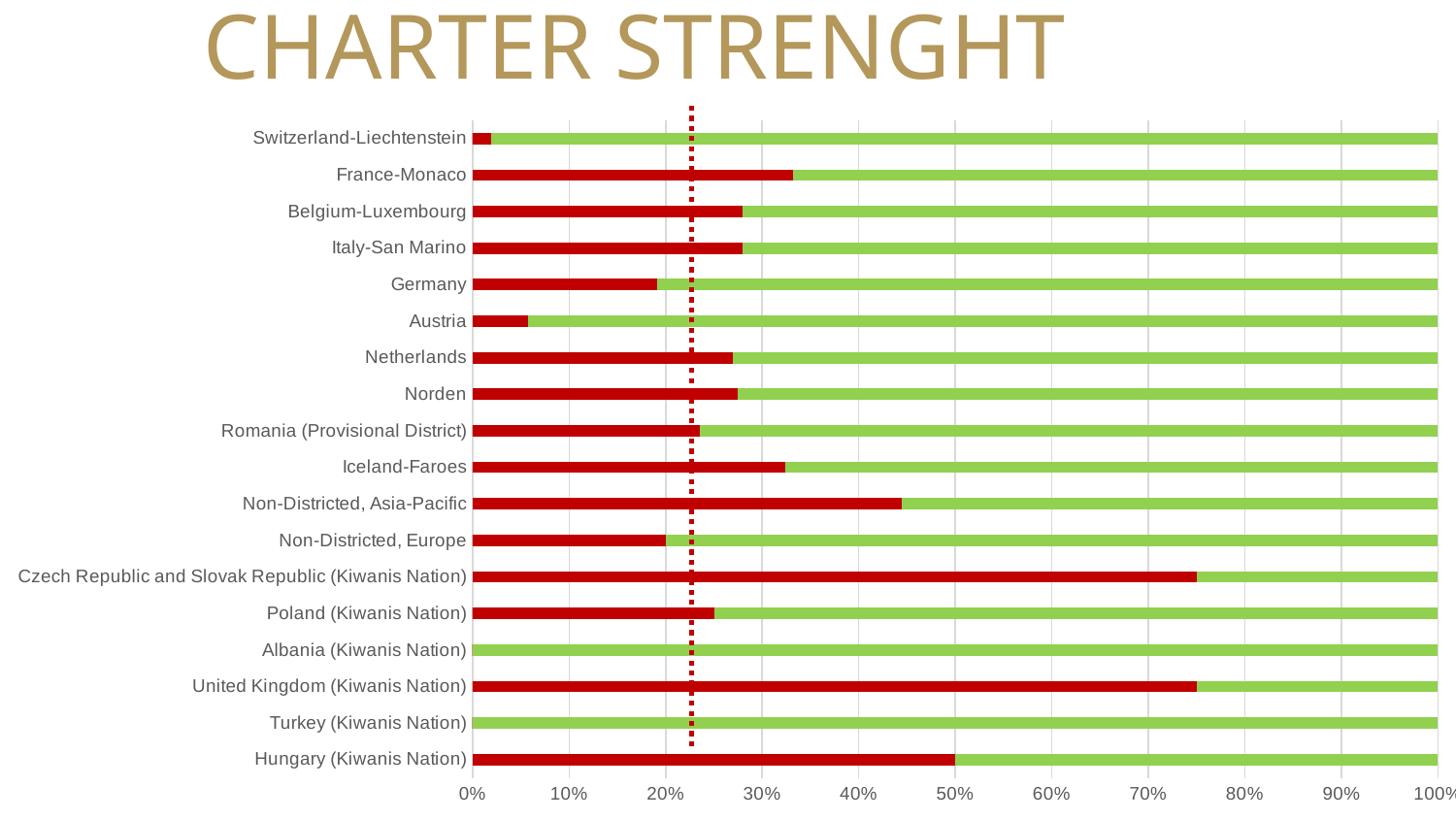
Which has the larger red segment, Austria or Iceland-Faroes? Iceland-Faroes Is the red segment for Czech Republic and Slovak Republic (Kiwanis Nation) greater or less than 70%? greater Is the red segment for Austria greater or less than 10%? less What is the title of the chart? CHARTER STRENGHT What is the total of the stacked bar for Germany? 100% Is the red segment for Switzerland-Liechtenstein greater or less than 10%? less What kind of chart is shown on the slide? Bar chart How many categories (districts/nations) are listed on the vertical axis? 18 What two colours are used for the bar segments in the chart? Red and green Which has the larger red segment, Hungary (Kiwanis Nation) or Poland (Kiwanis Nation)? Hungary (Kiwanis Nation)